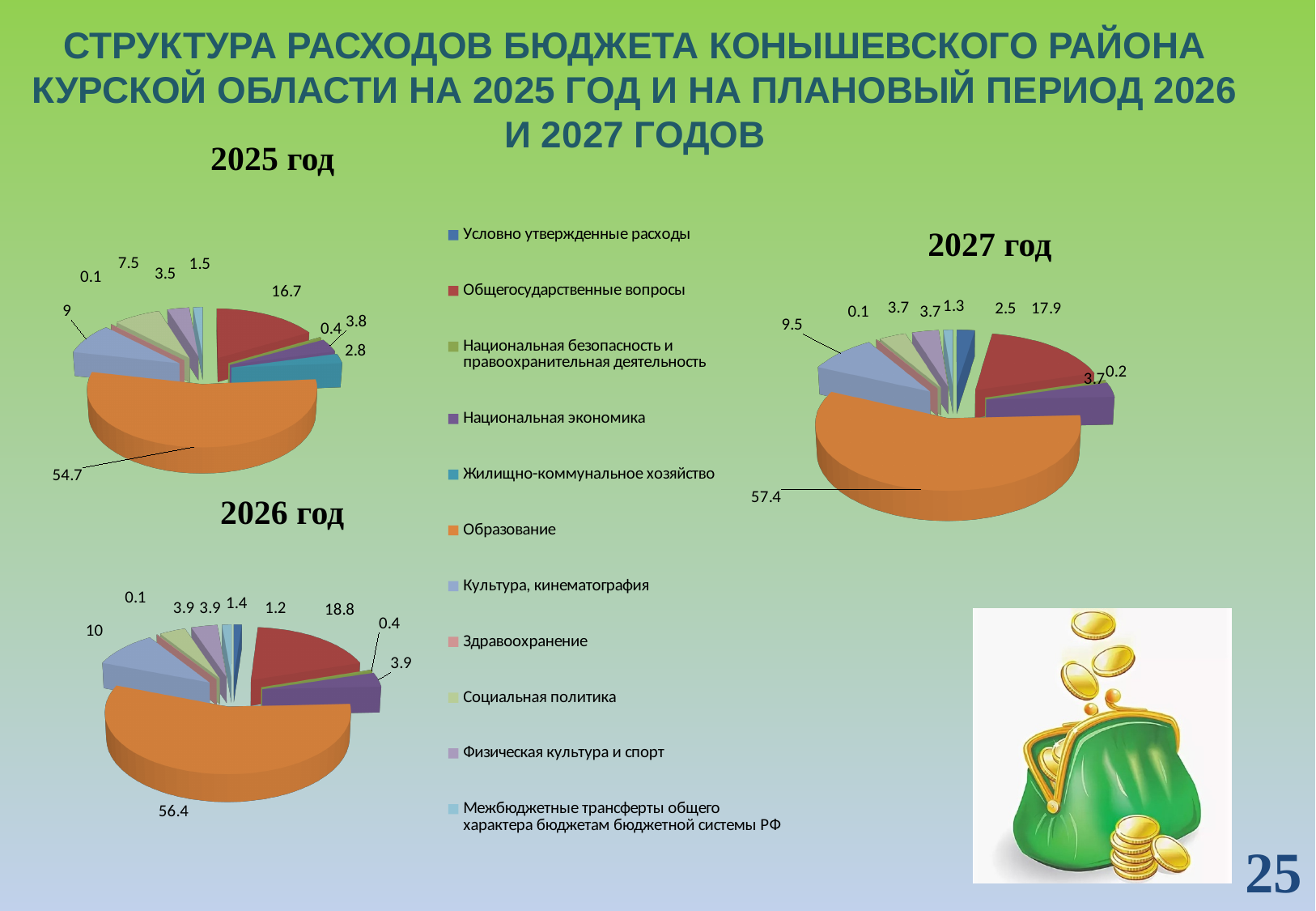
How many pie charts are on the slide? 3 On the 2027 год pie chart, which category has the largest share? Образование Which is larger on the 2025 год pie chart: Общегосударственные вопросы or Культура, кинематография? Общегосударственные вопросы On the 2026 год pie chart, what is the value for Условно утвержденные расходы? 1.2 On the 2026 год pie chart, what is the difference between Образование and Общегосударственные вопросы? 37.6 On the 2027 год pie chart, what is the value for Образование? 57.4 On the 2027 год pie chart, what is the value for Культура, кинематография? 9.5 How many categories does the legend list? 11 On the 2026 год pie chart, what is the value for Общегосударственные вопросы? 18.8 On the 2025 год pie chart, what is the value for Образование? 54.7 On the 2025 год pie chart, which category has the largest share? Образование What kind of chart is used to show the 2025 год budget structure? Pie chart